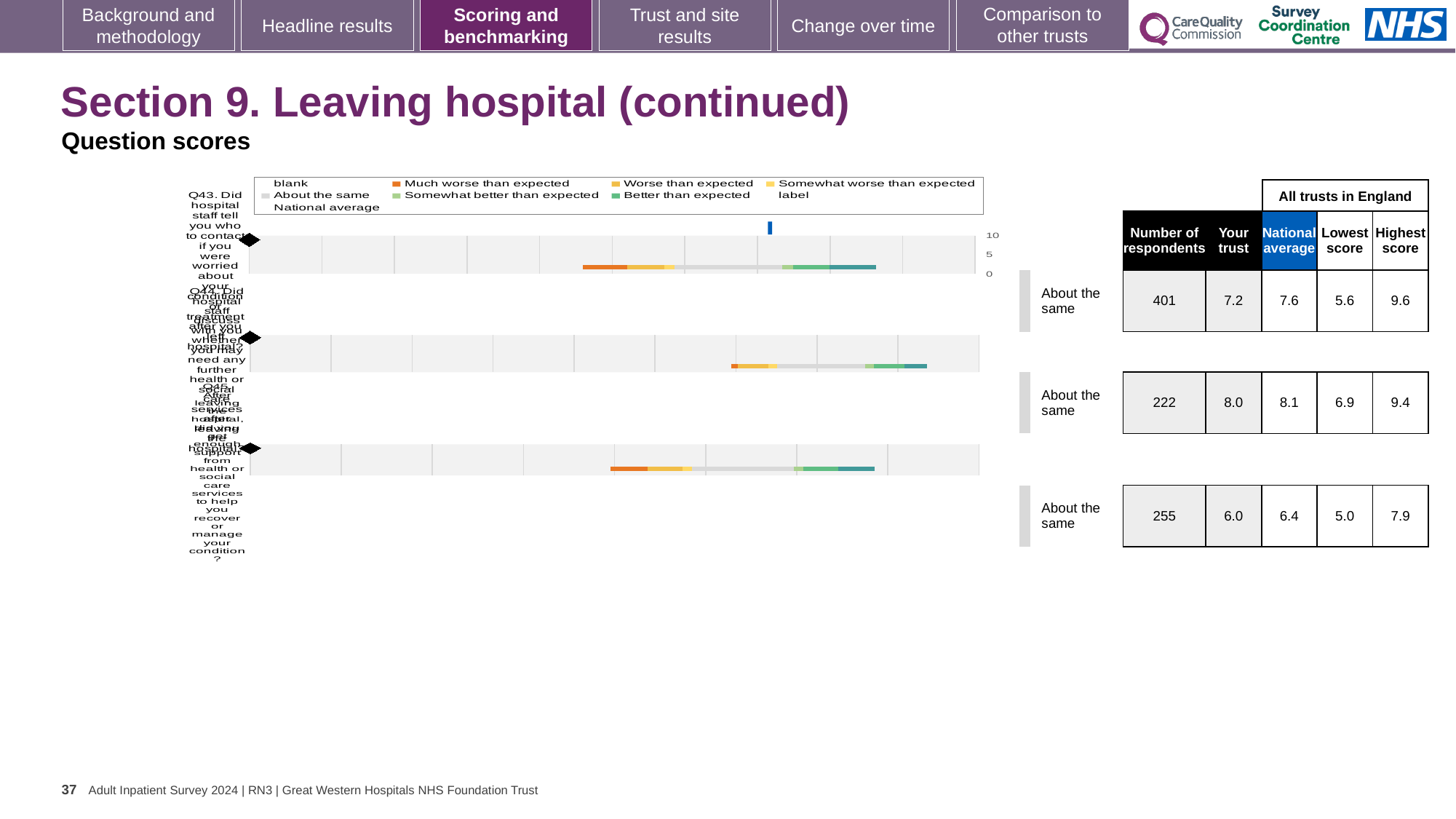
For the top chart (Q43), what is the 'Your trust' score? 7.2 What kind of chart is used to show the Q43 question score on this slide? bar chart For the top chart (Q43), what is the national average score? 7.6 Which of the three charts (top, middle or bottom) has the highest 'Your trust' score? middle For the top chart (Q43), which benchmark category is the trust's score placed in, according to the label to the right of the chart? About the same For the bottom chart, what is the lowest score across all trusts in England? 5.0 For the top chart (Q43), what is the difference between the highest score and the lowest score across all trusts in England? 4.0 How many question score charts are shown on the slide? 3 For the top chart (Q43), which is higher: the 'Your trust' score or the national average? National average For the middle chart, what is the highest score across all trusts in England? 9.4 For the top chart (Q43), what is the number of respondents shown in the table? 401